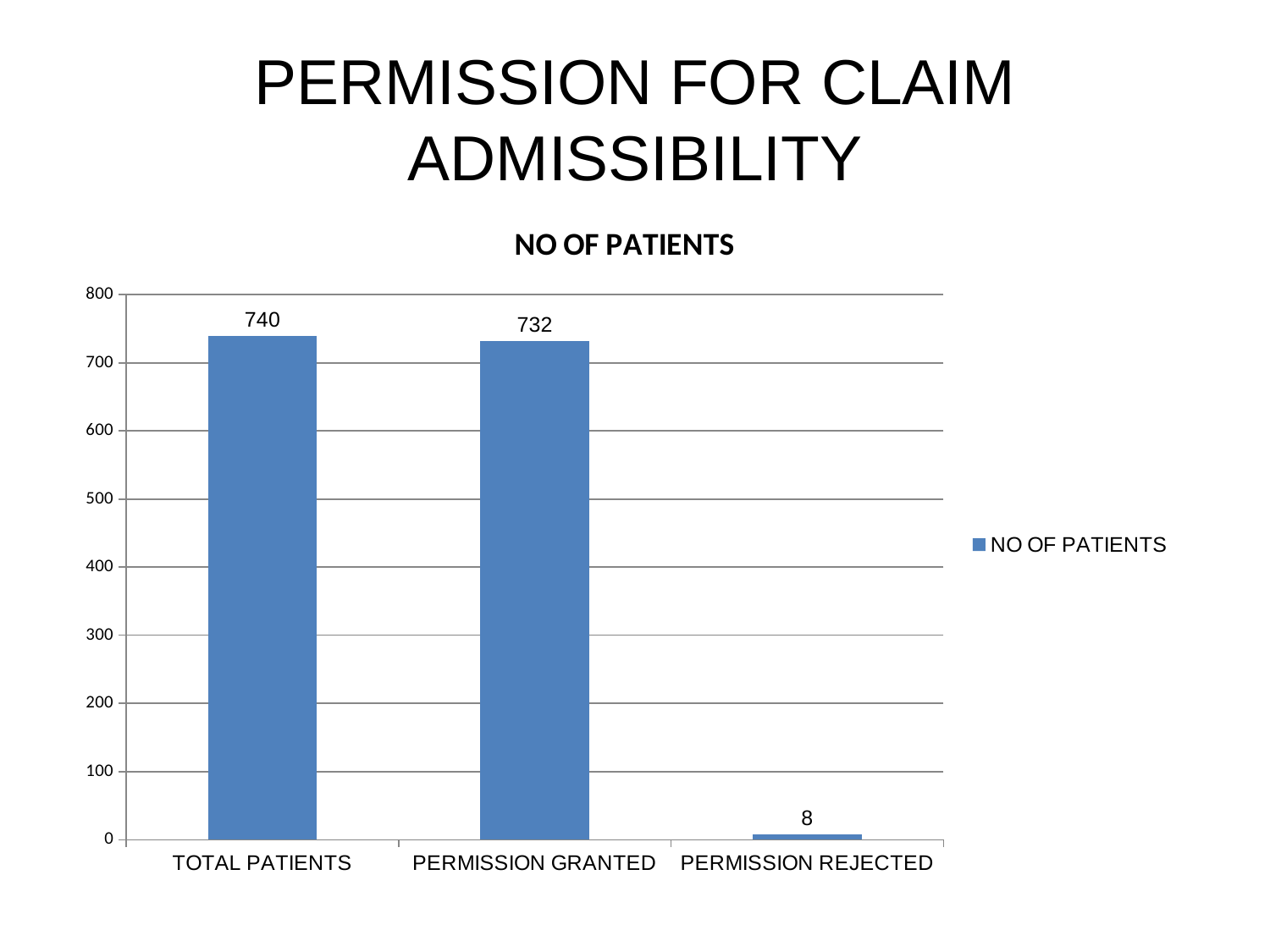
What is the difference between TOTAL PATIENTS and PERMISSION GRANTED? 8 How many series does the legend list? 1 What is the difference between PERMISSION GRANTED and PERMISSION REJECTED? 724 Which category has the highest value? TOTAL PATIENTS What is the value for TOTAL PATIENTS? 740 Which is larger, PERMISSION GRANTED or PERMISSION REJECTED? PERMISSION GRANTED What is the value for PERMISSION GRANTED? 732 Is the value for PERMISSION GRANTED greater or less than 700? greater What kind of chart is shown on the slide? bar chart Which category has the lowest value? PERMISSION REJECTED What is the value for PERMISSION REJECTED? 8 How many categories are shown on the x axis? 3